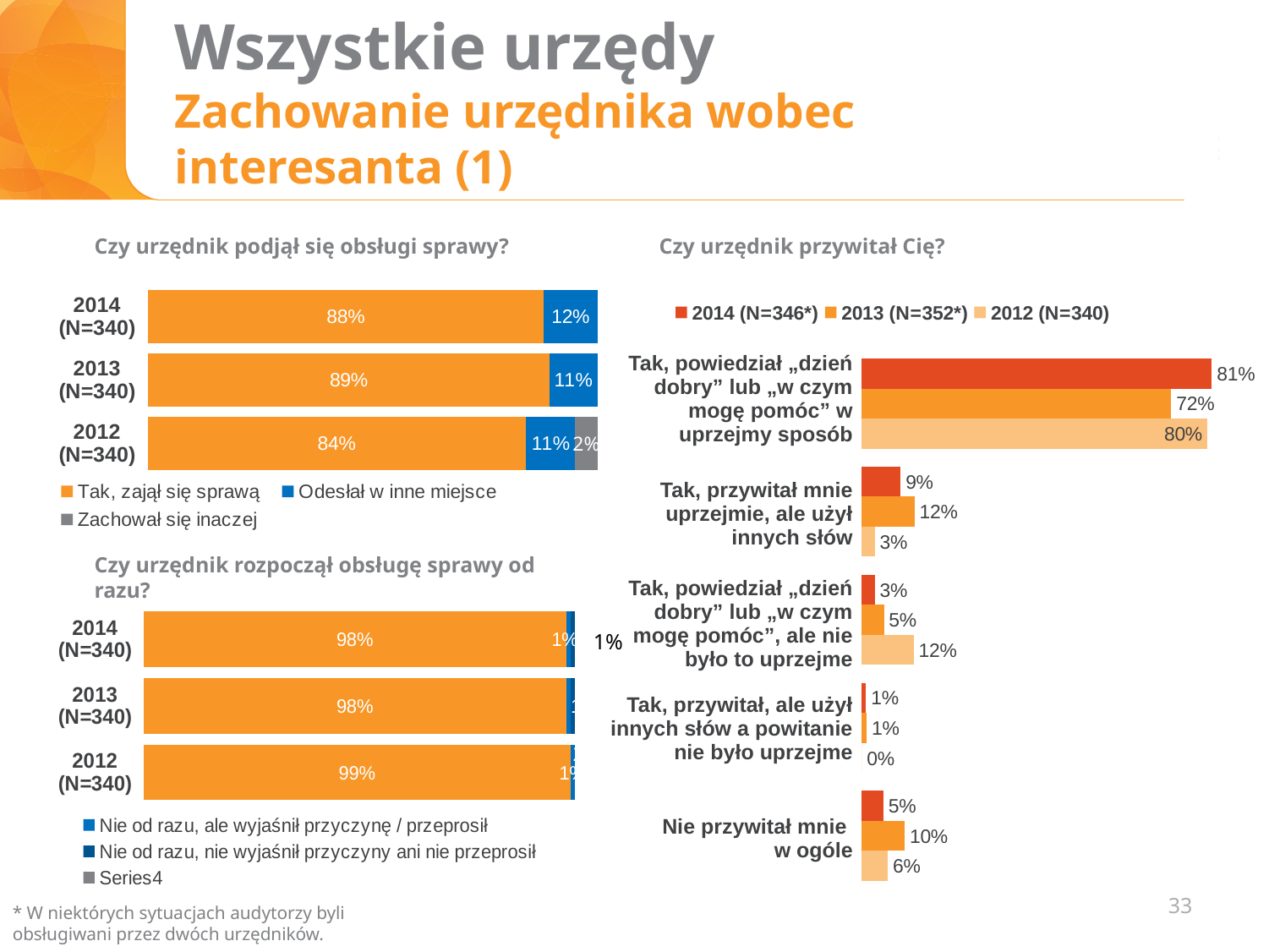
In the chart "Czy urzędnik rozpoczął obsługę sprawy od razu?", what is the largest value shown for 2012 (N=340)? 99% What type of chart is "Czy urzędnik przywitał Cię?"? Bar chart In the chart "Czy urzędnik podjął się obsługi sprawy?", which year has the highest value for "Tak, zajął się sprawą"? 2013 (N=340) In the chart "Czy urzędnik podjął się obsługi sprawy?", what is the difference between the "Tak, zajął się sprawą" values for 2013 and 2012? 5% In the chart "Czy urzędnik przywitał Cię?", what is the difference between the 2014 and 2013 values for "Tak, powiedział „dzień dobry” lub „w czym mogę pomóc” w uprzejmy sposób"? 9% In the chart "Czy urzędnik przywitał Cię?", what percentage is shown for 2013 (N=352*) in the category "Nie przywitał mnie w ogóle"? 10% In the chart "Czy urzędnik podjął się obsługi sprawy?", what percentage is shown for "Tak, zajął się sprawą" in 2014 (N=340)? 88% In the chart "Czy urzędnik podjął się obsługi sprawy?", how many series does the legend list? 3 In the chart "Czy urzędnik przywitał Cię?", which series has the highest value in the category "Tak, powiedział „dzień dobry” lub „w czym mogę pomóc”, ale nie było to uprzejme"? 2012 (N=340) In the chart "Czy urzędnik podjął się obsługi sprawy?", what percentage is shown for "Odesłał w inne miejsce" in 2012 (N=340)? 11% In the chart "Czy urzędnik przywitał Cię?", what percentage is shown for 2014 (N=346*) in the category "Tak, powiedział „dzień dobry” lub „w czym mogę pomóc” w uprzejmy sposób"? 81% In the chart "Czy urzędnik przywitał Cię?", how many categories are shown? 5